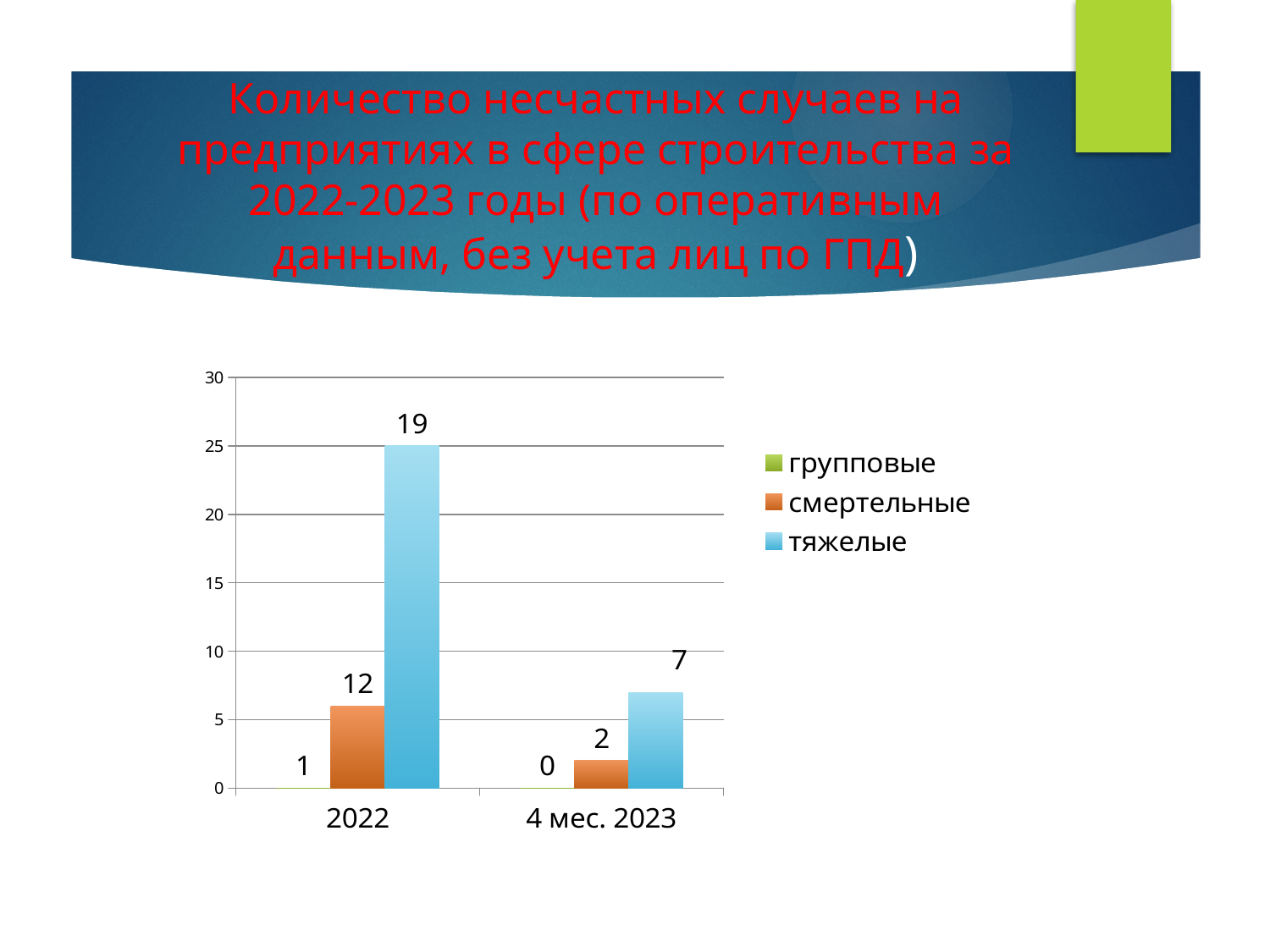
Which series has the lowest value in 4 мес. 2023? групповые How many series does the legend list? 3 What is the value for тяжелые in 2022? 19 Which series has the highest value in 2022? тяжелые What is the value for групповые in 2022? 1 What is the difference between the тяжелые values for 2022 and 4 мес. 2023? 12 What is the value for тяжелые in 4 мес. 2023? 7 What is the value for смертельные in 4 мес. 2023? 2 What is the value for смертельные in 2022? 12 What is the value for групповые in 4 мес. 2023? 0 What kind of chart is shown on the slide? bar chart